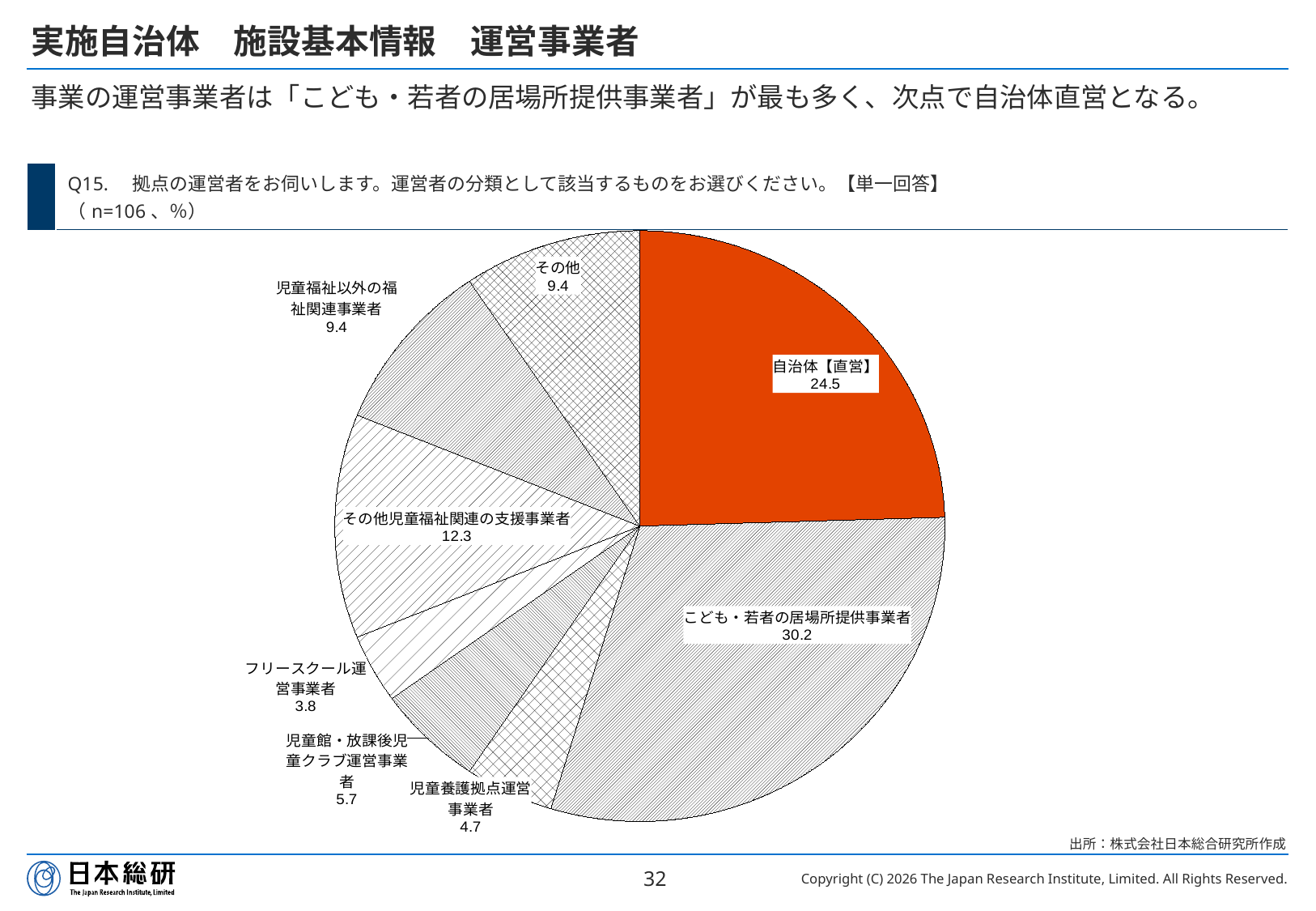
How many categories are shown in the pie chart? 8 What is the value for こども・若者の居場所提供事業者? 30.2 What kind of chart is shown on the slide? pie chart Which is larger, the value for 児童館・放課後児童クラブ運営事業者 or the value for 児童養護拠点運営事業者? 児童館・放課後児童クラブ運営事業者 Which category has the smallest share of the pie? フリースクール運営事業者 What is the value for その他児童福祉関連の支援事業者? 12.3 What is the difference between the values for こども・若者の居場所提供事業者 and 自治体【直営】? 5.7 Which category has the largest share of the pie? こども・若者の居場所提供事業者 What is the value for フリースクール運営事業者? 3.8 What is the sample size (n) stated for the chart? 106 What is the value for 児童養護拠点運営事業者? 4.7 What is the value for 自治体【直営】? 24.5